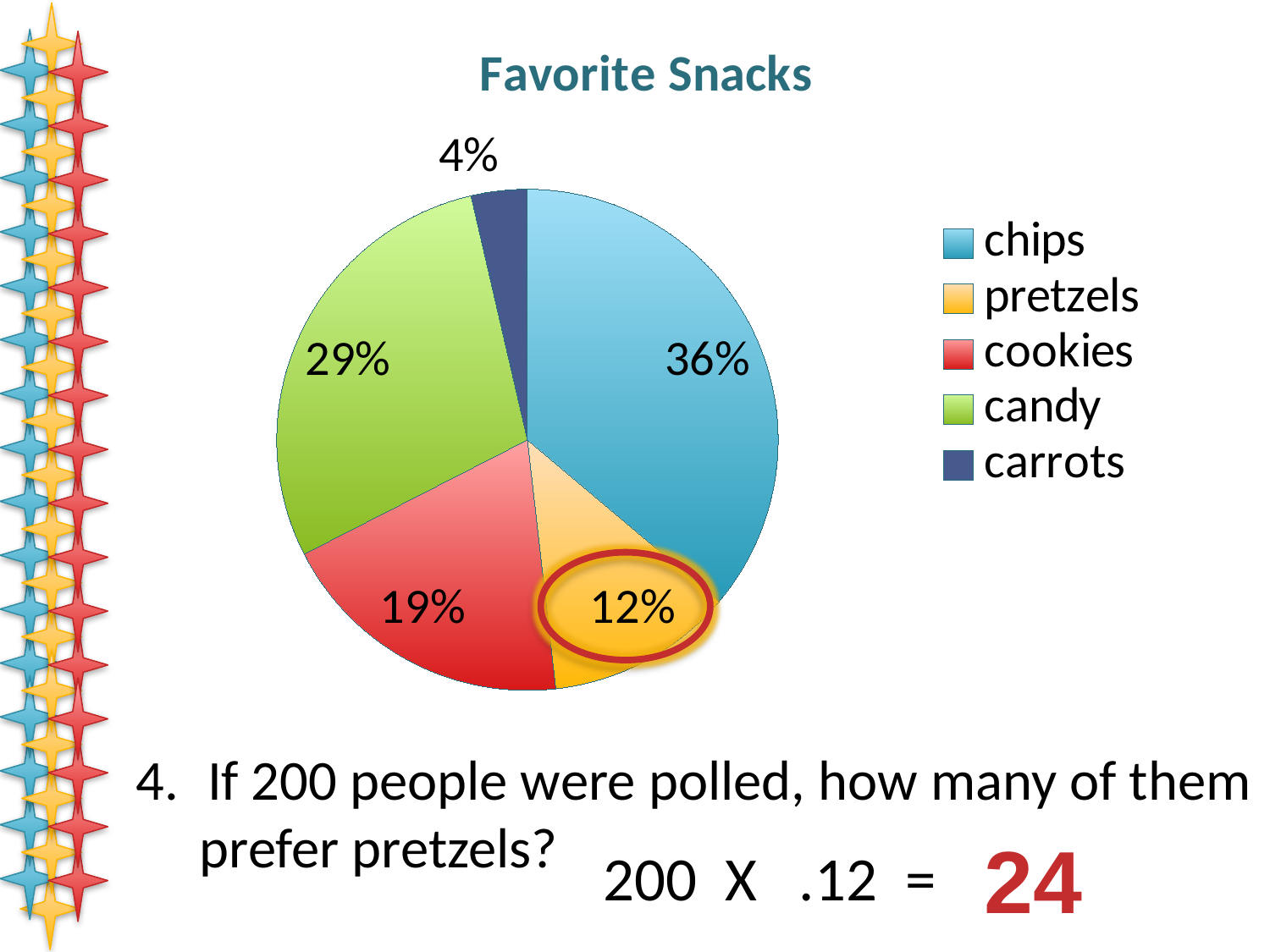
What percentage of the pie chart is for carrots? 4% Which snack has the largest share of the pie chart? chips How many slices does the pie chart have? 5 What kind of chart is shown on the slide? pie chart What is the difference in percentage points between cookies and pretzels? 7 What is the title of the chart? Favorite Snacks What is the difference in percentage points between chips and candy? 7 Which has a larger share, cookies or pretzels? cookies Which slice of the pie chart is circled in red? pretzels (12%) What percentage of the pie chart is for chips? 36% Which snack has the smallest share of the pie chart? carrots What percentage of the pie chart is for candy? 29%